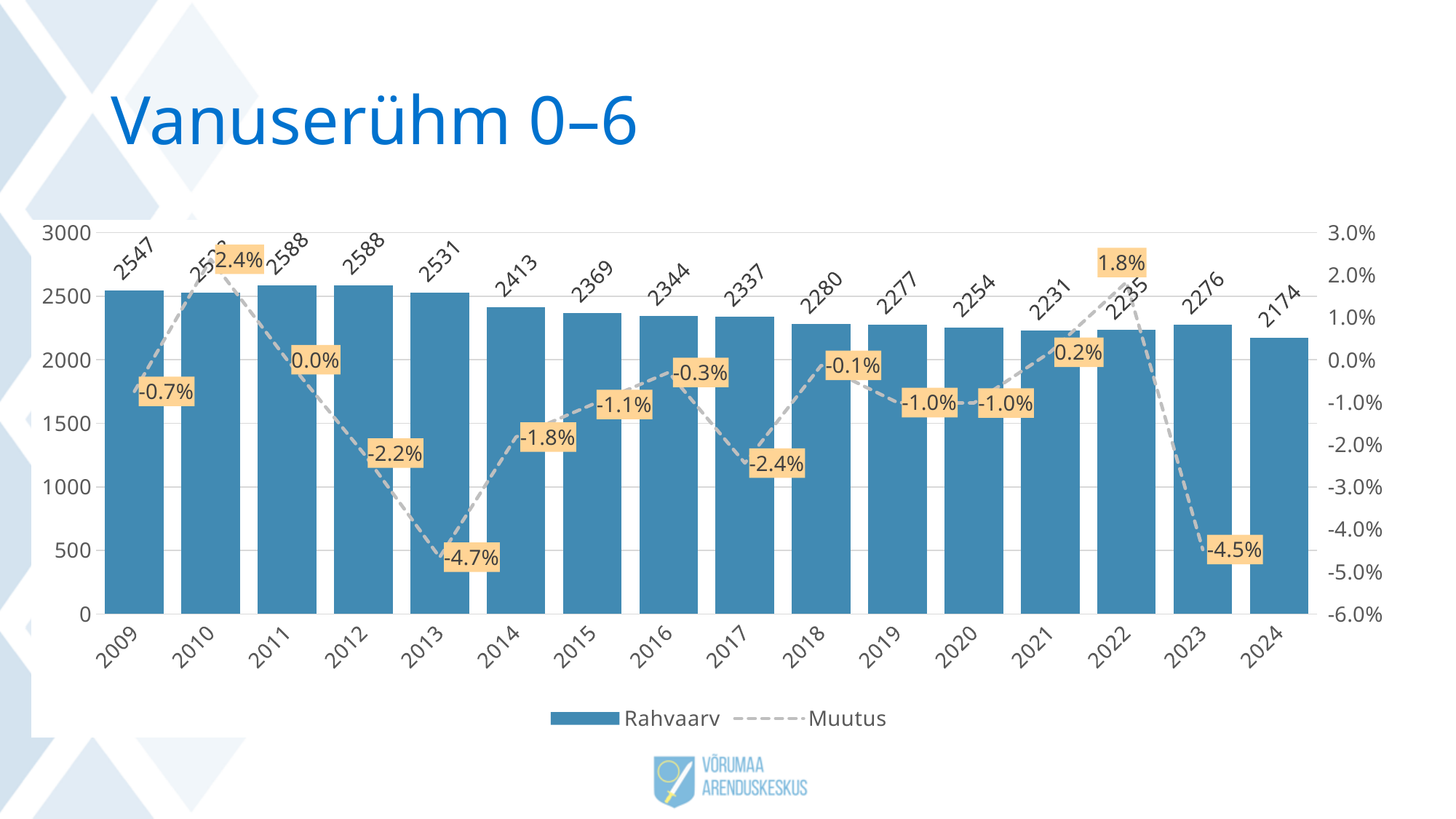
How many years are shown on the x axis? 16 What is the Rahvaarv value for 2024? 2174 Which year has the lowest Muutus value? 2013 What is the Rahvaarv value for 2009? 2547 Which year has the highest Muutus value? 2010 What is the title of the slide containing the chart? Vanuserühm 0–6 What is the Muutus value for 2013? -4.7% Which is larger, the Rahvaarv value for 2023 or for 2022? 2023 How many series does the legend list? 2 Which year has the lowest Rahvaarv value? 2024 What is the difference between the Rahvaarv values for 2011 and 2024? 414 What is the Muutus value for 2022? 1.8%